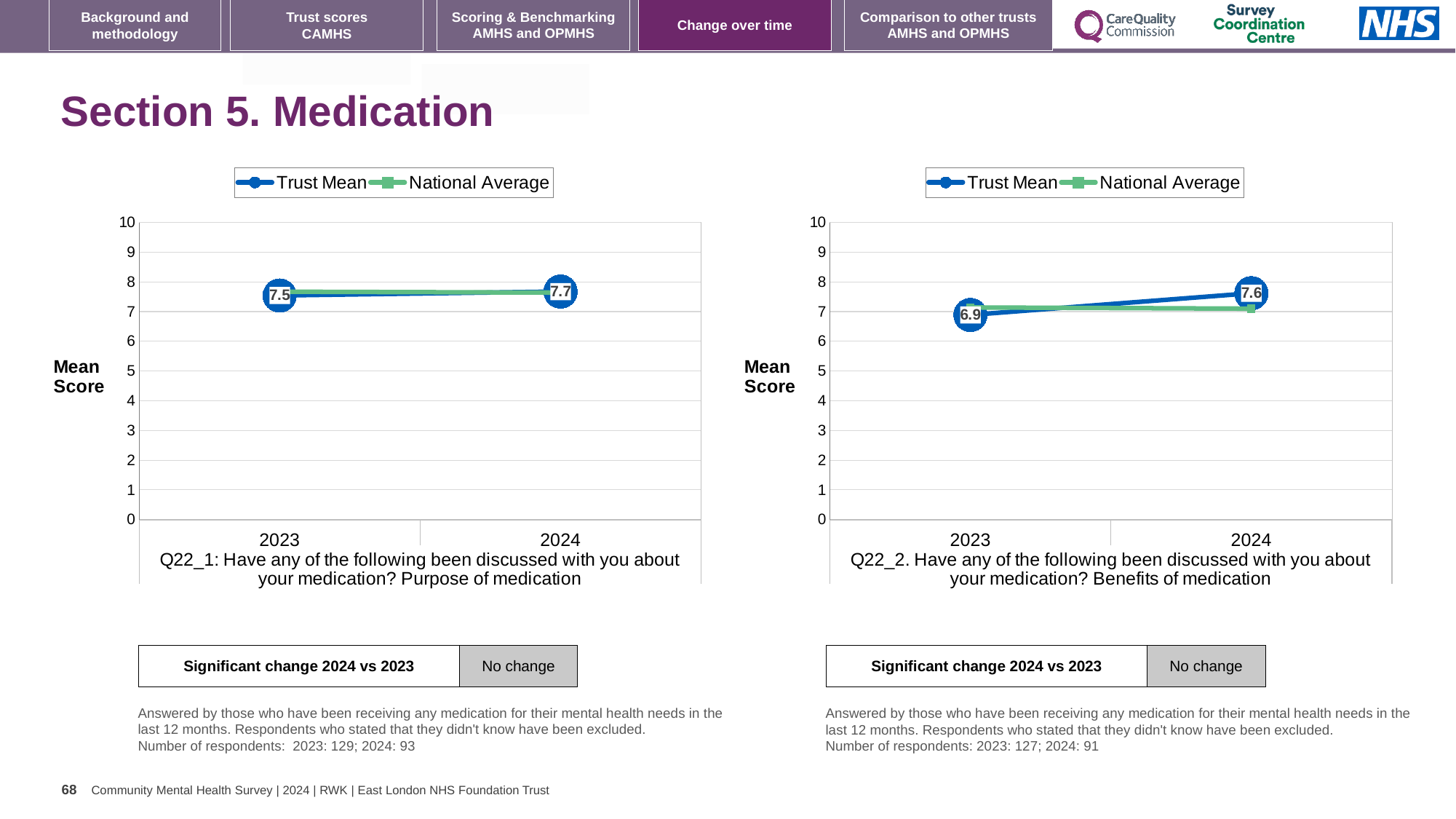
In the left chart (Q22_1: Purpose of medication), what is the Trust Mean for 2023? 7.5 In the left chart (Q22_1: Purpose of medication), what is the difference between the Trust Mean in 2024 and 2023? 0.2 In the right chart (Q22_2: Benefits of medication), what is the Trust Mean for 2024? 7.6 How many series does the legend of the left chart list? 2 In the right chart (Q22_2: Benefits of medication), does the Trust Mean rise or fall from 2023 to 2024? rise In the right chart (Q22_2: Benefits of medication), what is the Trust Mean for 2023? 6.9 In the right chart (Q22_2: Benefits of medication), is the Trust Mean for 2023 greater or less than 7? less In the right chart (Q22_2: Benefits of medication), by how much did the Trust Mean change from 2023 to 2024? 0.7 In the left chart (Q22_1: Purpose of medication), what is the Trust Mean for 2024? 7.7 What type of chart is used in the right chart (Q22_2: Benefits of medication)? line chart How many years are plotted on the x axis of the left chart (Q22_1: Purpose of medication)? 2 In the left chart (Q22_1: Purpose of medication), is the National Average for 2024 greater or less than 7? greater